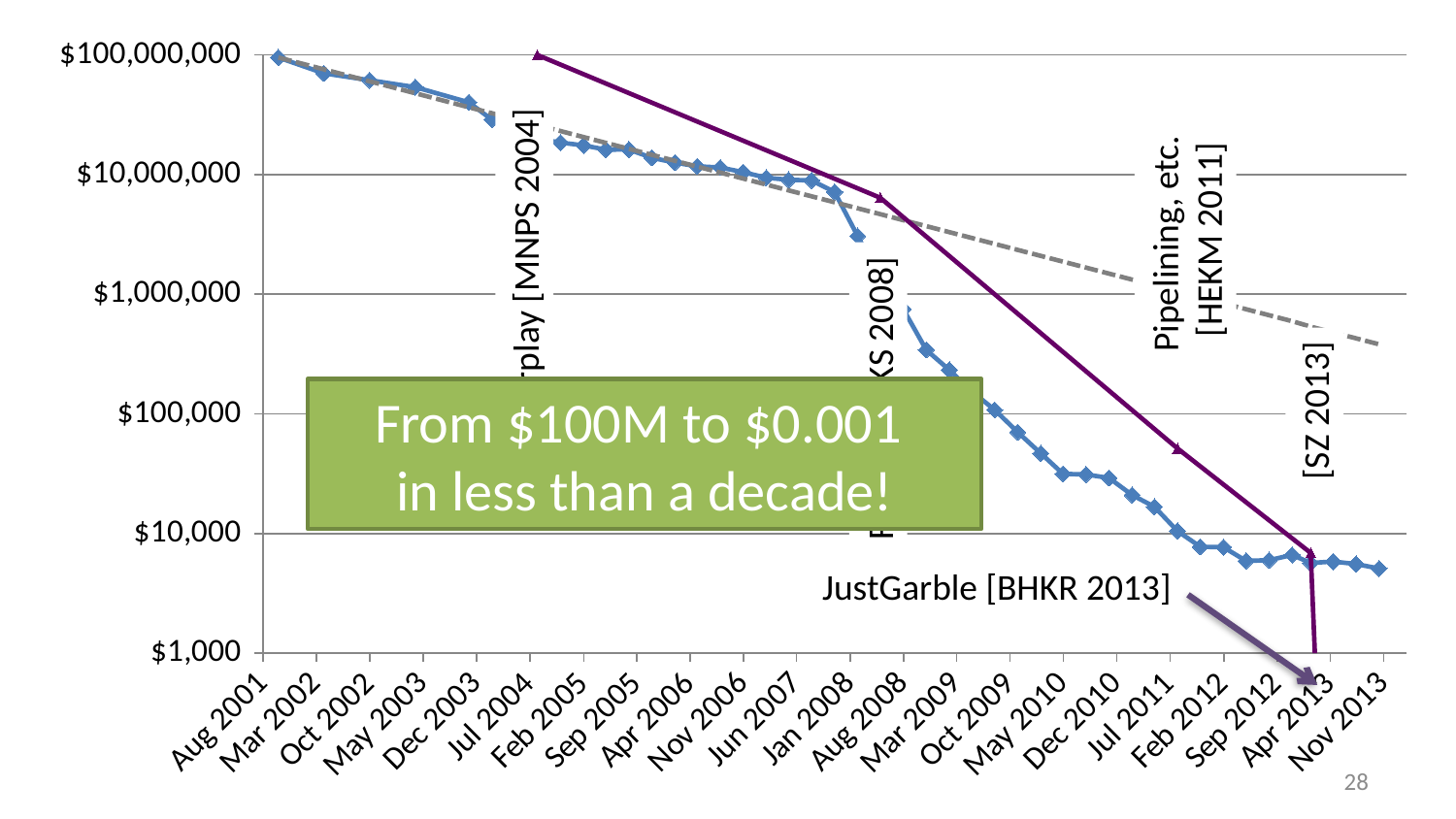
Which citation is attached to the annotation "Pipelining, etc."? [HEKM 2011] Is the value of the blue line at Nov 2013 greater or less than $10,000? less Is the value of the purple line at Aug 2008 greater or less than $1,000,000? greater Is the value of the blue line at Mar 2009 greater or less than $100,000? greater Do the plotted values rise or fall as time moves from Aug 2001 to Nov 2013? fall What does the green box on the chart say? From $100M to $0.001 in less than a decade! Which is larger: the purple line's value at Jul 2004 or the blue line's value at Feb 2005? purple line at Jul 2004 What kind of chart is shown on the slide? line chart Which is larger: the blue line's value at Aug 2001 or its value at Nov 2013? Aug 2001